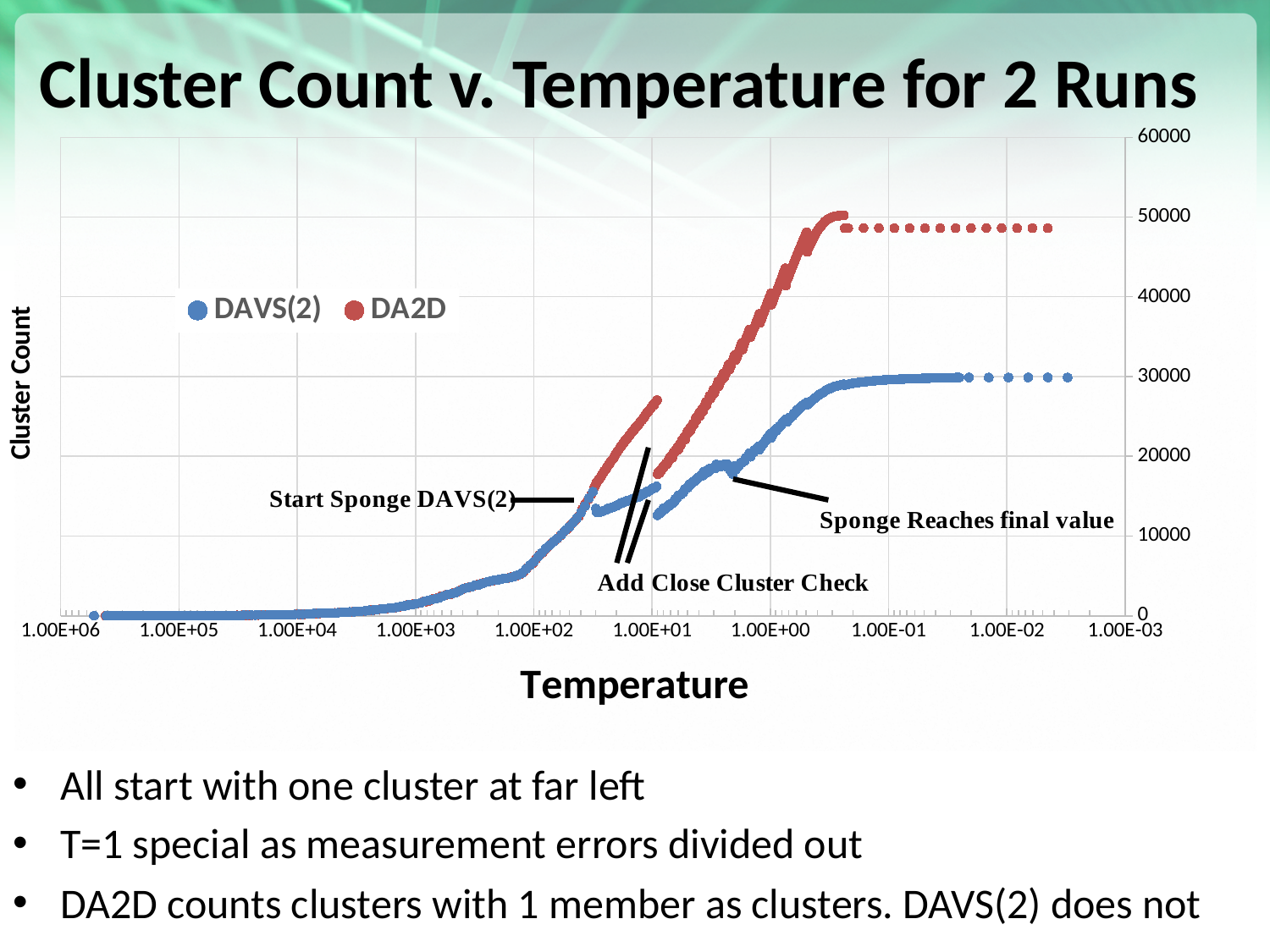
Moving from left to right along the x axis, does the DA2D cluster count generally rise or fall before it levels off? rise Which series reaches the highest cluster count? DA2D Which series has the lower cluster count at the far right of the chart? DAVS(2) How many series does the legend list? 2 At the far right of the chart, which series has the higher cluster count, DAVS(2) or DA2D? DA2D Is the DAVS(2) cluster count at a temperature of 1.00E+02 greater or less than 10000? less Is the final plateau value of DAVS(2) greater or less than 20000? greater Moving from left to right along the x axis, does the DAVS(2) cluster count generally rise or fall? rise What is the title of the x axis? Temperature What kind of chart is shown on the slide? scatter chart Is the final plateau value of DA2D greater or less than 40000? greater What are the two series named in the legend? DAVS(2) and DA2D